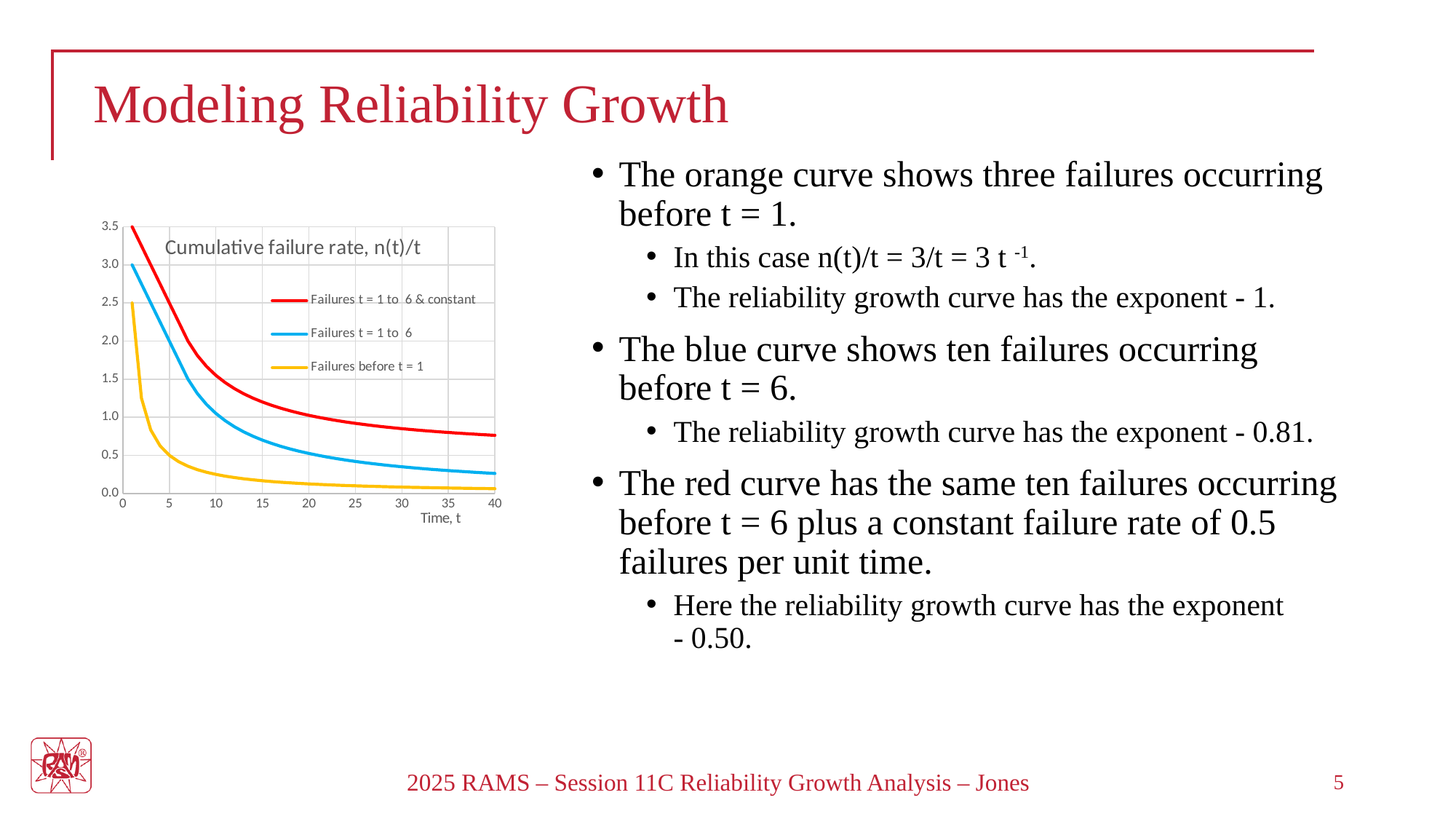
Do the values of the 'Failures before t = 1' series rise or fall along the x axis? fall What is the title of the chart? Cumulative failure rate, n(t)/t Is the value of the 'Failures t = 1 to 6' series at t = 40 greater or less than 0.5? less What kind of chart is shown on the slide? line chart How many series does the chart legend list? 3 Is the value of the 'Failures before t = 1' series at t = 10 greater or less than 0.5? less Is the value of the 'Failures t = 1 to 6 & constant' series at t = 40 greater or less than 0.5? greater Which series has the highest value at t = 40? Failures t = 1 to 6 & constant Do the values of the 'Failures t = 1 to 6 & constant' series rise or fall as time increases? fall At t = 20, which is larger: the 'Failures t = 1 to 6 & constant' series or the 'Failures t = 1 to 6' series? Failures t = 1 to 6 & constant What is the label of the x axis of the chart? Time, t Which series has the lowest value at t = 40? Failures before t = 1